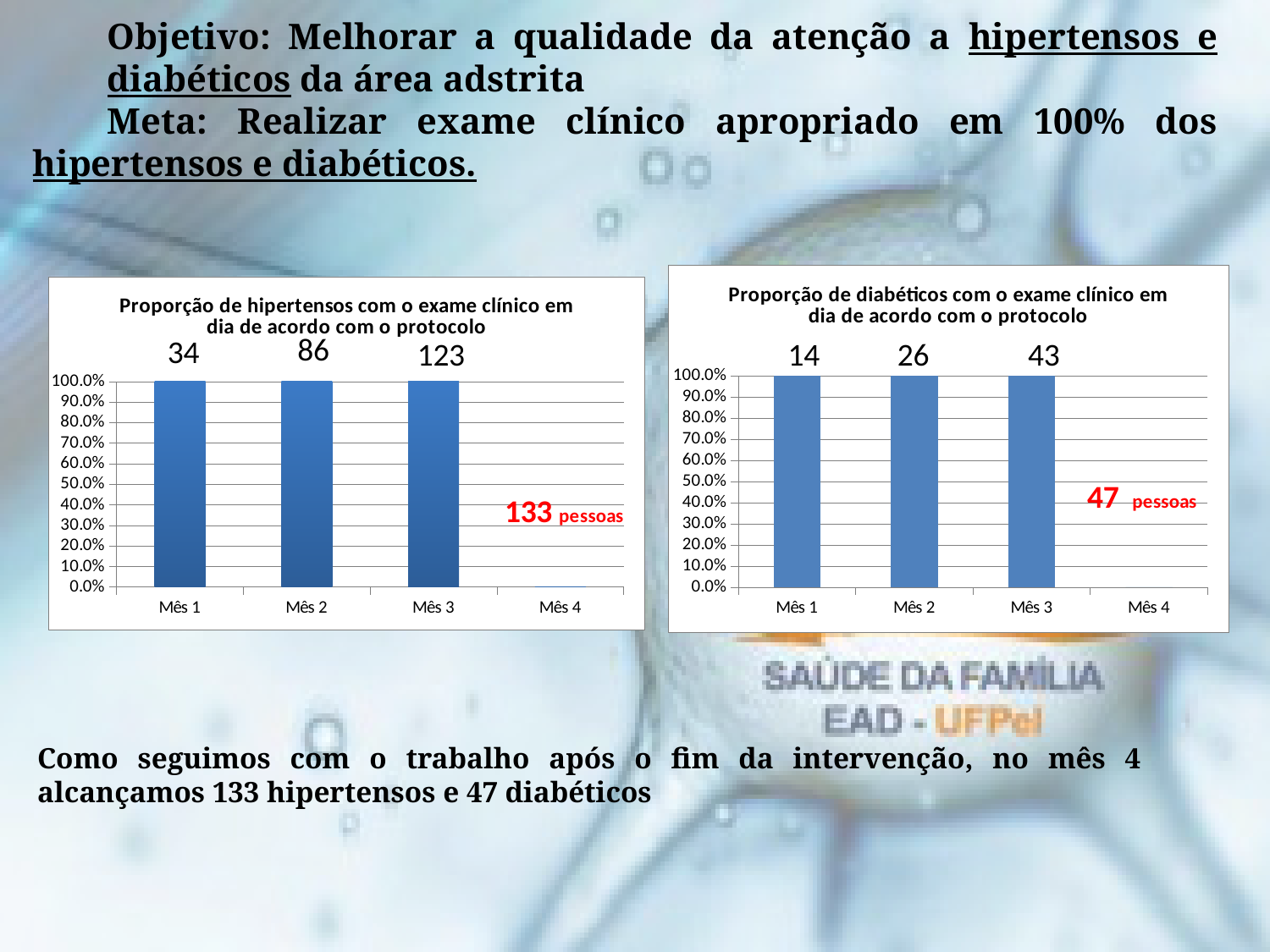
In the chart titled 'Proporção de hipertensos com o exame clínico em dia de acordo com o protocolo', what red annotation is written near Mês 4? 133 pessoas In the chart titled 'Proporção de hipertensos com o exame clínico em dia de acordo com o protocolo', what is the difference between the numbers printed above the Mês 3 and Mês 1 bars? 89 In the chart titled 'Proporção de diabéticos com o exame clínico em dia de acordo com o protocolo', what is the difference between the numbers printed above the Mês 3 and Mês 1 bars? 29 In the chart titled 'Proporção de hipertensos com o exame clínico em dia de acordo com o protocolo', what number is printed above the bar for Mês 3? 123 In the chart titled 'Proporção de hipertensos com o exame clínico em dia de acordo com o protocolo', do the numbers printed above the bars rise or fall from Mês 1 to Mês 3? rise In the chart titled 'Proporção de diabéticos com o exame clínico em dia de acordo com o protocolo', what red annotation is written near Mês 4? 47 pessoas In the chart titled 'Proporção de diabéticos com o exame clínico em dia de acordo com o protocolo', what number is printed above the bar for Mês 2? 26 In the chart titled 'Proporção de diabéticos com o exame clínico em dia de acordo com o protocolo', which month has the highest number printed above its bar? Mês 3 In the chart titled 'Proporção de hipertensos com o exame clínico em dia de acordo com o protocolo', what percentage does the bar for Mês 2 reach? 100.0% In the chart titled 'Proporção de diabéticos com o exame clínico em dia de acordo com o protocolo', is the value for Mês 1 greater or less than 50.0%? greater In the chart titled 'Proporção de hipertensos com o exame clínico em dia de acordo com o protocolo', how many month categories are shown on the x axis? 4 In the chart titled 'Proporção de hipertensos com o exame clínico em dia de acordo com o protocolo', what kind of chart is shown? bar chart